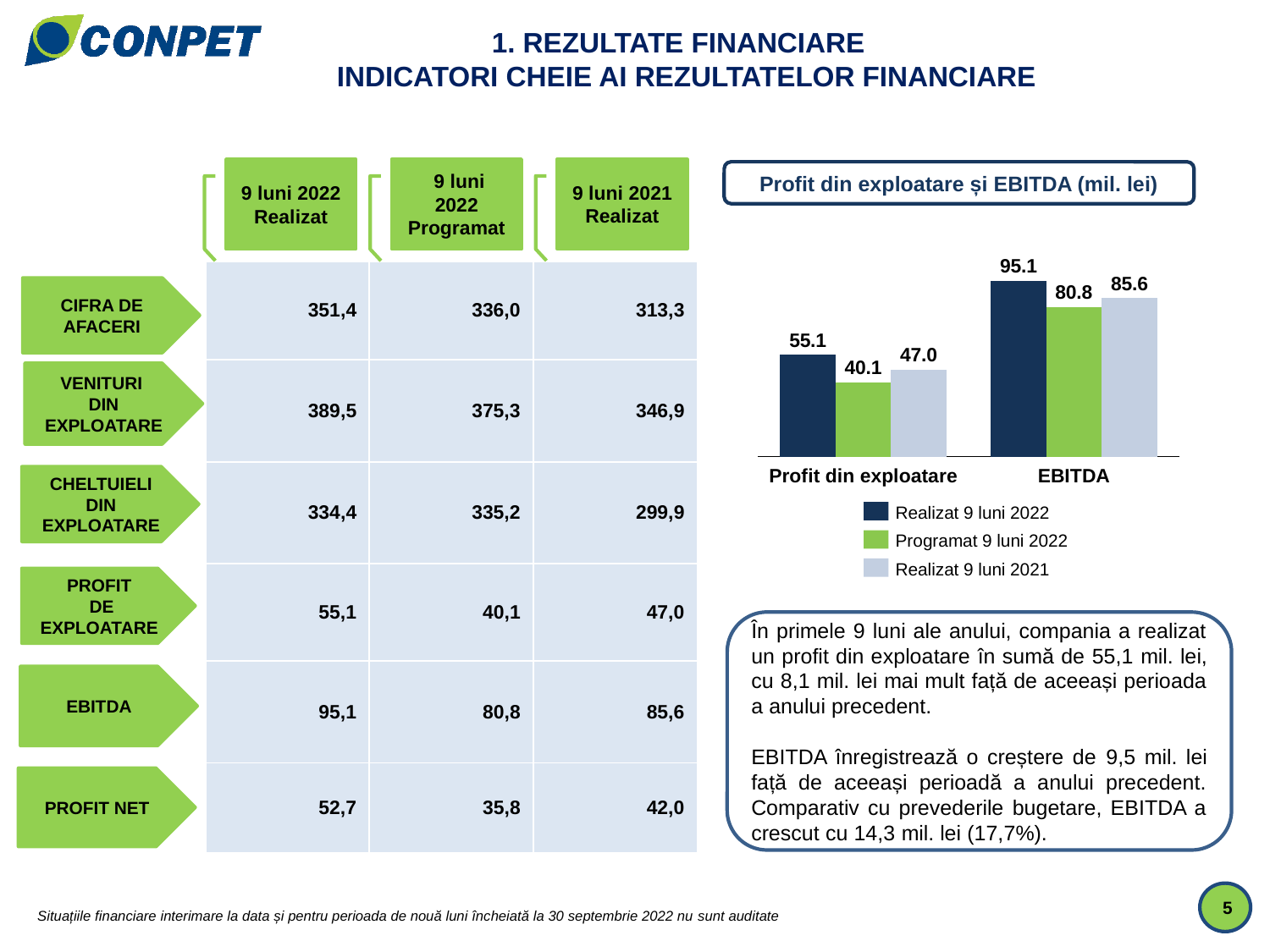
Which series has the lowest value in the Profit din exploatare category? Programat 9 luni 2022 What type of chart is shown on the slide? Bar chart What is the difference between Realizat 9 luni 2022 and Realizat 9 luni 2021 in the EBITDA category? 9.5 What is the difference between Realizat 9 luni 2022 and Programat 9 luni 2022 in the Profit din exploatare category? 15.0 What is the value for Realizat 9 luni 2021 in the EBITDA category? 85.6 What is the value for Programat 9 luni 2022 in the EBITDA category? 80.8 Which series has the highest value in the EBITDA category? Realizat 9 luni 2022 How many series does the chart legend list? 3 Which is larger in the Profit din exploatare category: Programat 9 luni 2022 or Realizat 9 luni 2021? Realizat 9 luni 2021 How many categories are shown on the x axis of the chart? 2 What is the value for Realizat 9 luni 2021 in the Profit din exploatare category? 47.0 What is the value for Realizat 9 luni 2022 in the Profit din exploatare category? 55.1